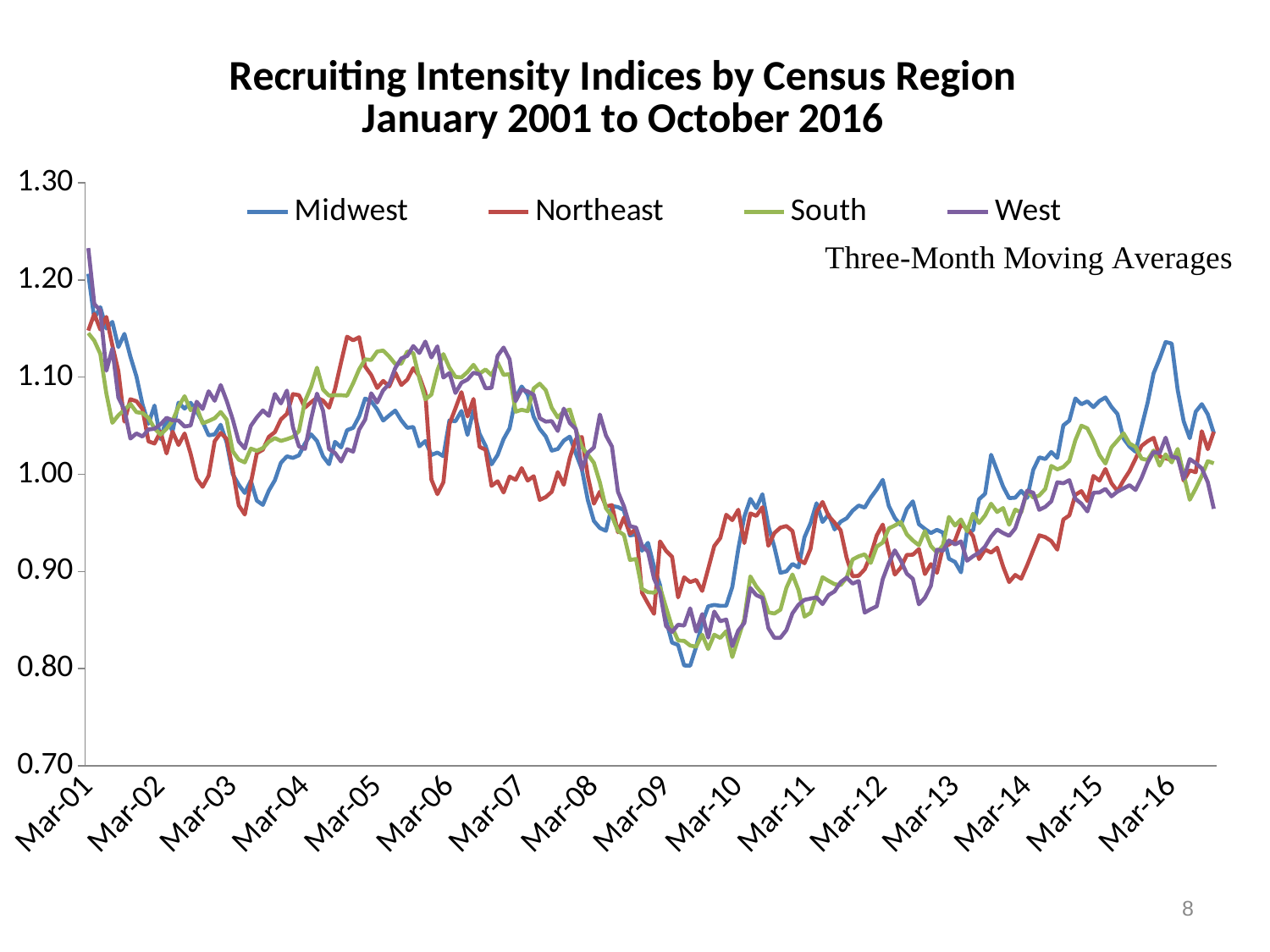
What is the title of the chart? Recruiting Intensity Indices by Census Region January 2001 to October 2016 Is the value for West at Mar-01 greater or less than 1.20? greater What note appears in the upper right of the plot area describing how the series are computed? Three-Month Moving Averages Is the value for Midwest at its lowest point around late 2009 greater or less than 0.90? less Which series is highest at Mar-16? Midwest What kind of chart is shown on the slide? line chart Which series is lowest at Mar-14? Northeast Is the value for Midwest at its peak around Mar-16 greater or less than 1.10? greater How many series does the legend list? 4 Does the Midwest series rise or fall between Mar-07 and Mar-09? fall How many year labels are shown on the x axis? 16